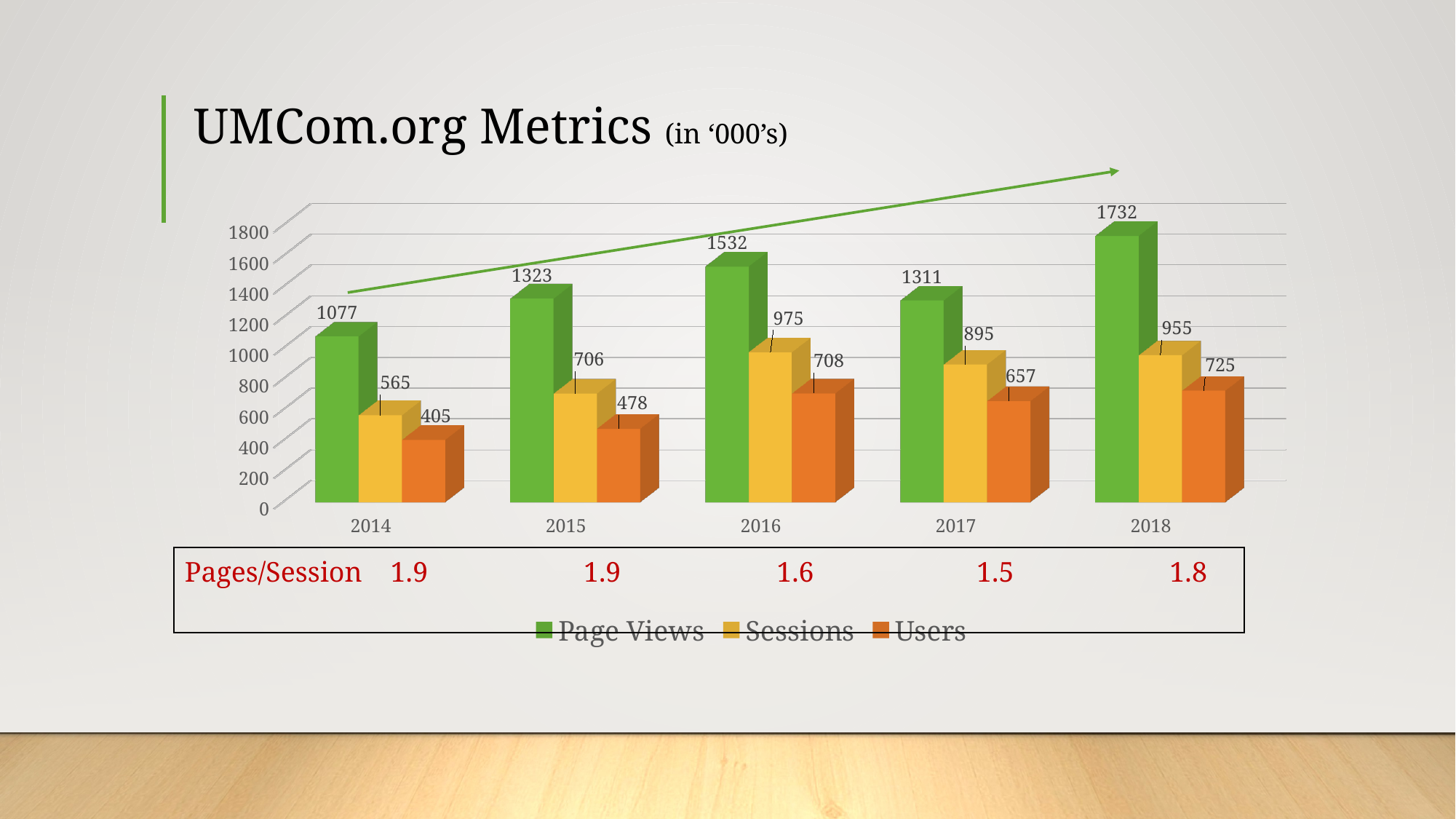
Which year has the lowest Users value? 2014 Which is larger, Sessions in 2016 or Sessions in 2018? Sessions in 2016 Which year has the highest Page Views? 2018 What is the Page Views value for 2016? 1532 How many years are shown on the x axis? 5 What is the Users value for 2014? 405 What is the difference between Page Views in 2018 and 2017? 421 How many series does the legend list? 3 Did Page Views rise or fall from 2016 to 2017? Fall What kind of chart is shown on the slide? Bar chart What is the Sessions value for 2017? 895 Which colour represents the Users series in the legend? Orange